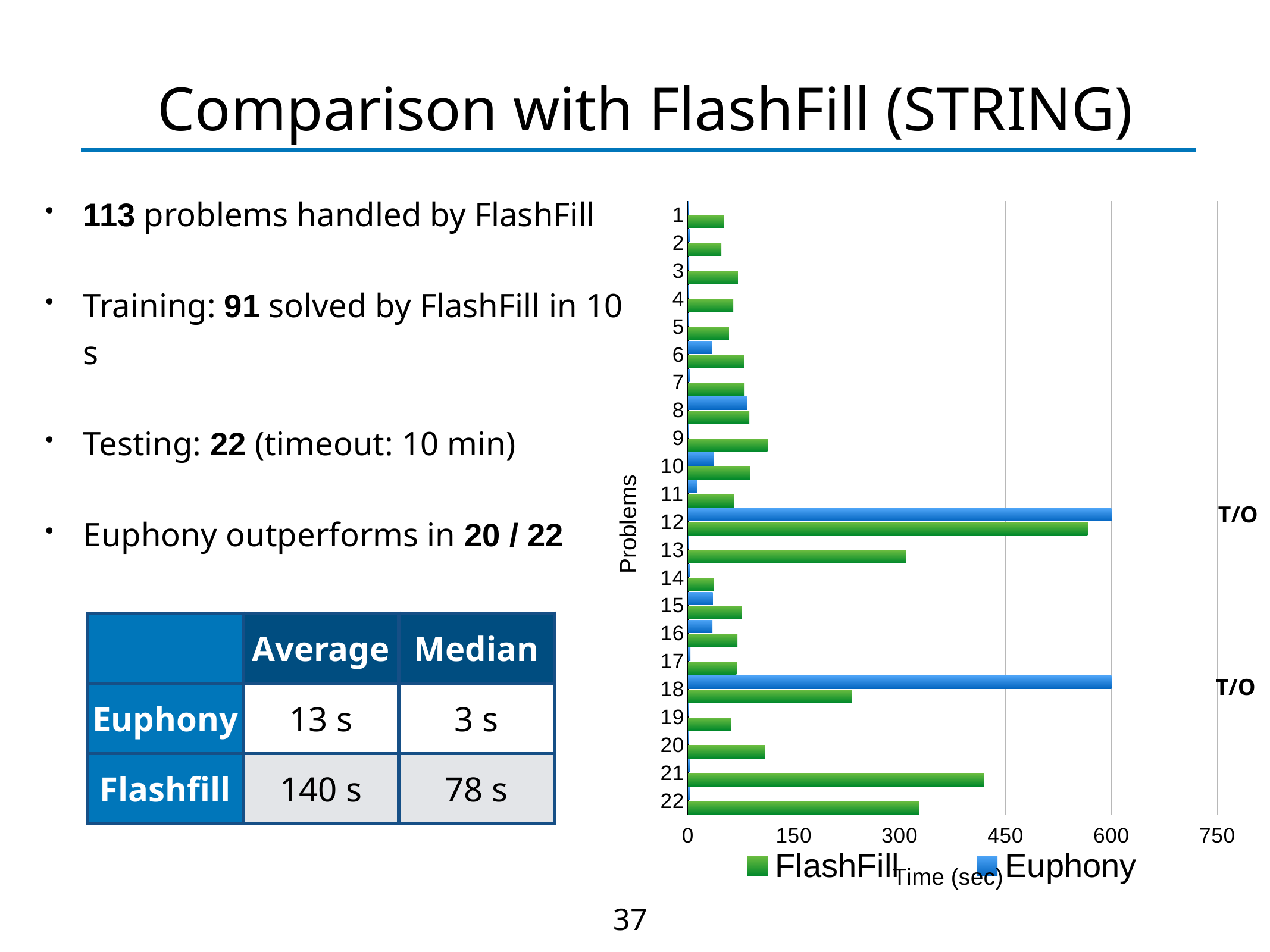
What is the title of the chart's x axis? Time (sec) Which problem has the highest FlashFill time in the chart? 12 What kind of chart is shown on the slide? bar chart Is the FlashFill time for problem 21 greater or less than 450? less Which problems have the highest Euphony time (marked T/O) in the chart? 12 and 18 How many problems are plotted on the chart's y axis? 22 Is the Euphony time for problem 1 greater or less than 150? less For problem 21, which series has the larger time, FlashFill or Euphony? FlashFill Is the FlashFill time for problem 22 greater or less than 300? greater For problem 12, which series has the larger time, FlashFill or Euphony? Euphony How many series does the chart legend list? 2